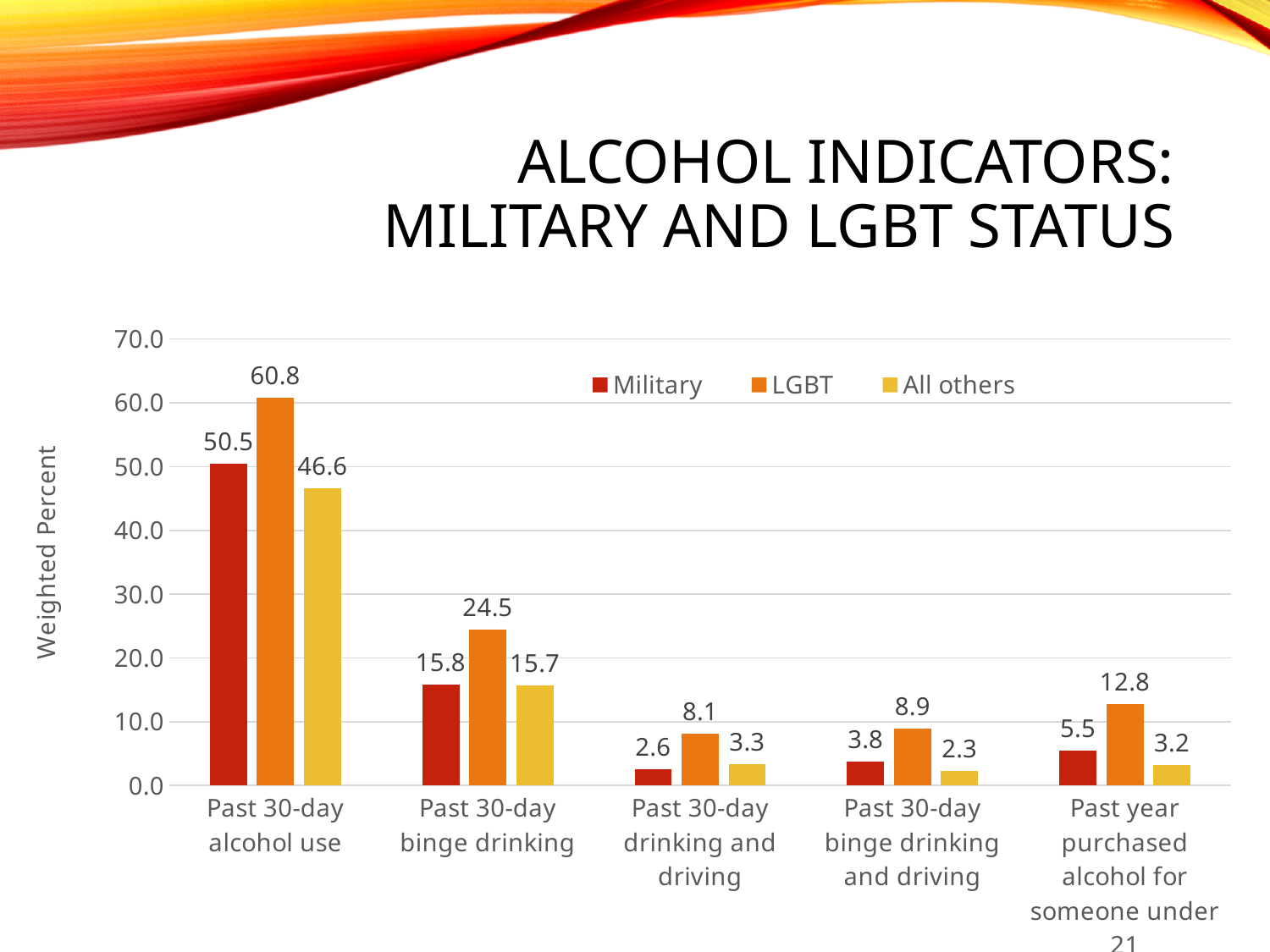
What is the difference between the LGBT and Military values for Past 30-day binge drinking? 8.7 What kind of chart is shown on the slide? Bar chart Which category has the highest LGBT value? Past 30-day alcohol use How many categories are shown on the x axis? 5 How many series does the legend list? 3 Which is larger for Past 30-day binge drinking and driving: the Military value or the All others value? Military What is the Military value for Past 30-day binge drinking? 15.8 What is the LGBT value for Past 30-day alcohol use? 60.8 Which category has the lowest Military value? Past 30-day drinking and driving Is the LGBT value for Past 30-day alcohol use greater or less than 60.0? greater What is the label of the vertical axis? Weighted Percent What is the All others value for Past year purchased alcohol for someone under 21? 3.2